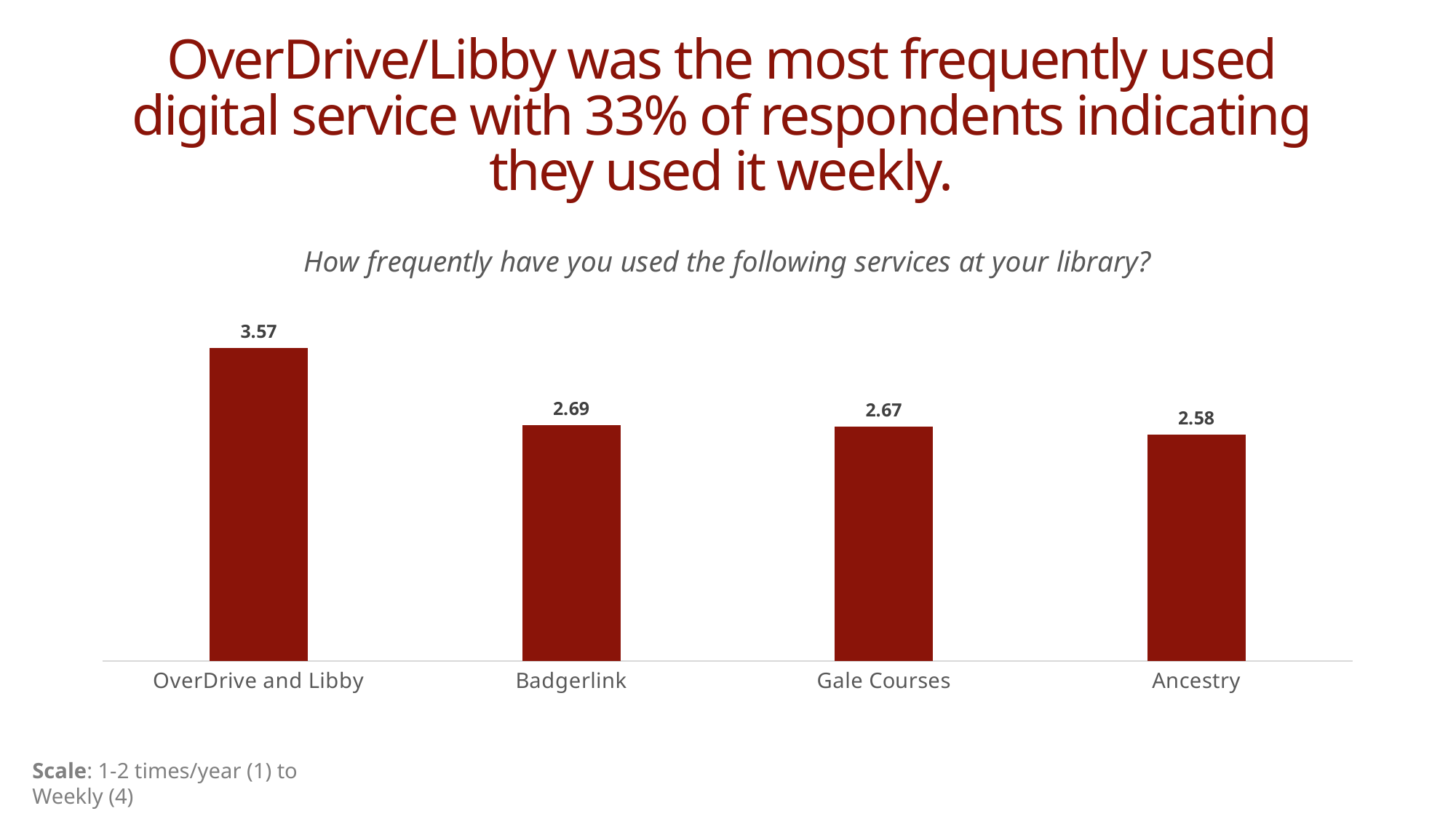
What is the value for Ancestry? 2.58 What kind of chart is shown on the slide? Bar chart What is the value for OverDrive and Libby? 3.57 What is the value for Gale Courses? 2.67 What is the difference between the values for Badgerlink and Ancestry? 0.11 What question is shown as the chart's subtitle? How frequently have you used the following services at your library? What is the difference between the values for OverDrive and Libby and Badgerlink? 0.88 Which service has the highest value? OverDrive and Libby What is the value for Badgerlink? 2.69 Which service has the lowest value? Ancestry Which has a larger value, OverDrive and Libby or Ancestry? OverDrive and Libby How many services are shown in the chart? 4